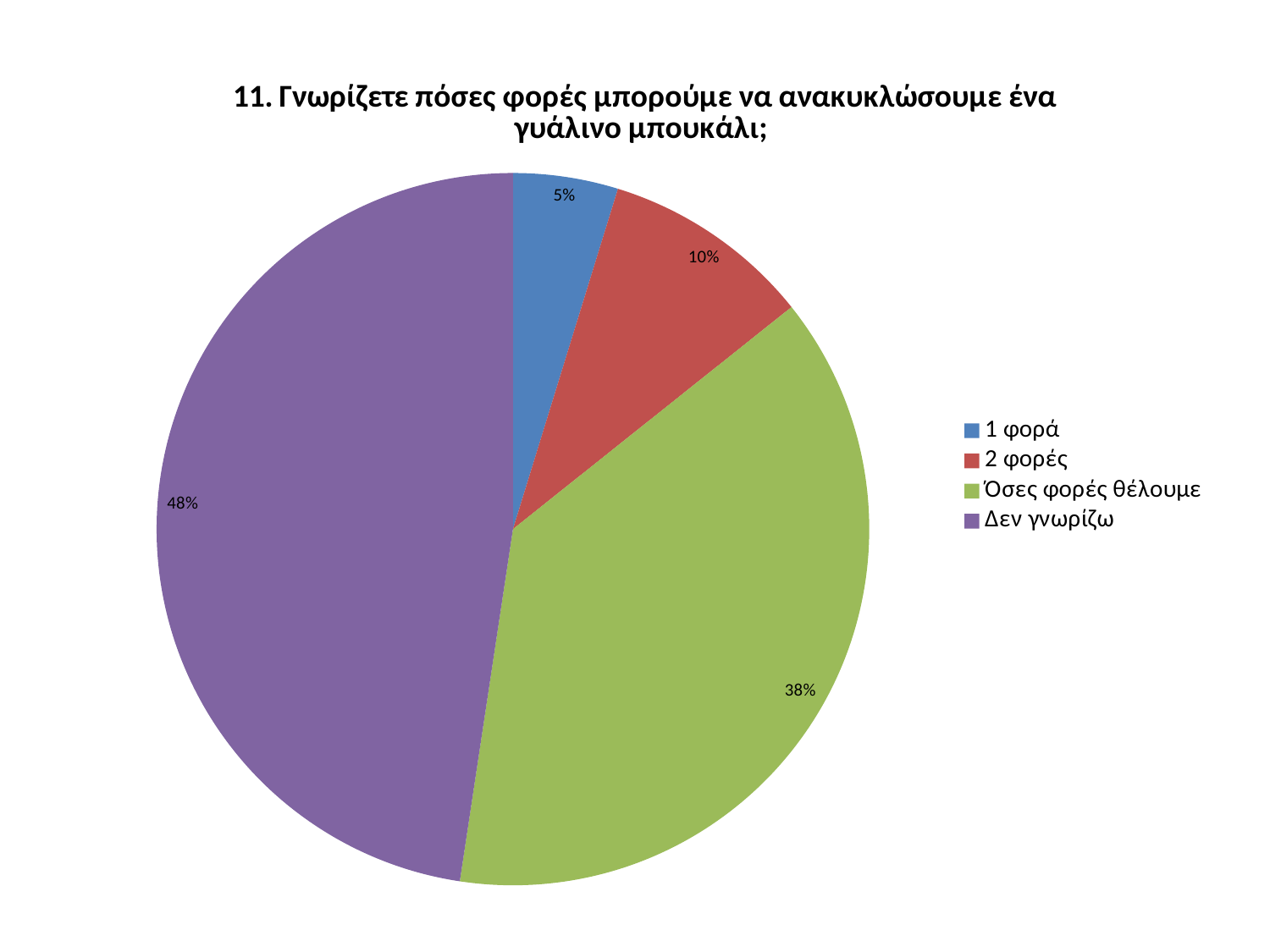
What is the value shown for "2 φορές"? 10% Which category has the largest slice of the pie? Δεν γνωρίζω What is the difference between the shares for "Δεν γνωρίζω" and "Όσες φορές θέλουμε"? 10% What share of the pie does "Δεν γνωρίζω" represent? 48% What is the value shown for "Όσες φορές θέλουμε"? 38% What is the combined share of "1 φορά" and "2 φορές"? 15% What is the value shown for "1 φορά"? 5% What colour is the slice for "Όσες φορές θέλουμε"? Green What kind of chart is shown on the slide? Pie chart Which category has the smallest slice of the pie? 1 φορά Which is larger, the share for "2 φορές" or the share for "1 φορά"? 2 φορές How many categories does the pie chart show? 4